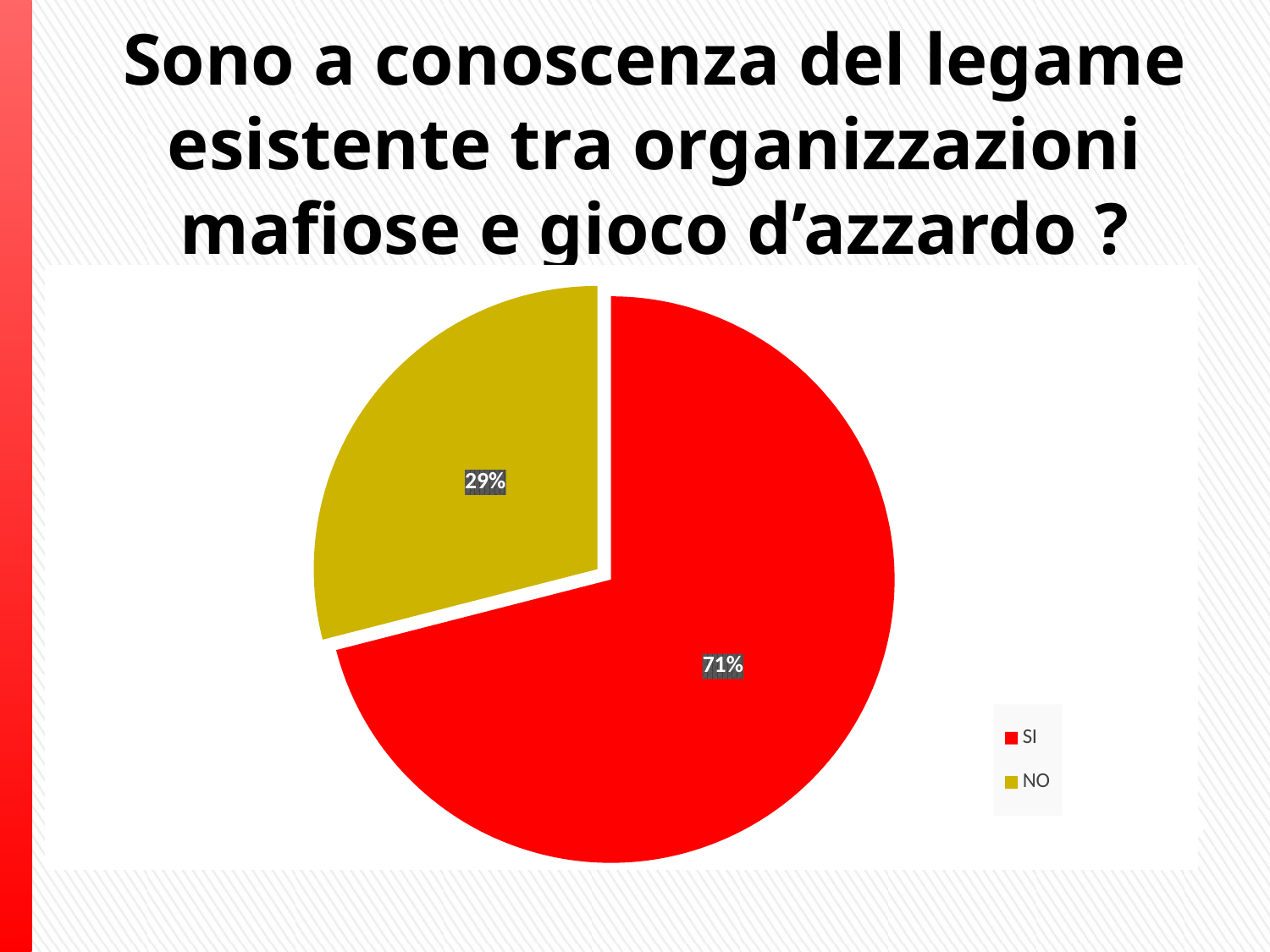
What colour is the SI slice? red What share of the pie does the NO slice represent? 29% What is the difference in percentage points between the SI and NO slices? 42 What share of the pie does the SI slice represent? 71% What kind of chart is shown on the slide? pie chart How many entries does the legend list? 2 Which category has the largest slice of the pie? SI How many slices does the pie chart have? 2 Which slice is larger, SI or NO? SI Which category has the smallest slice of the pie? NO What colour is the NO slice? yellow